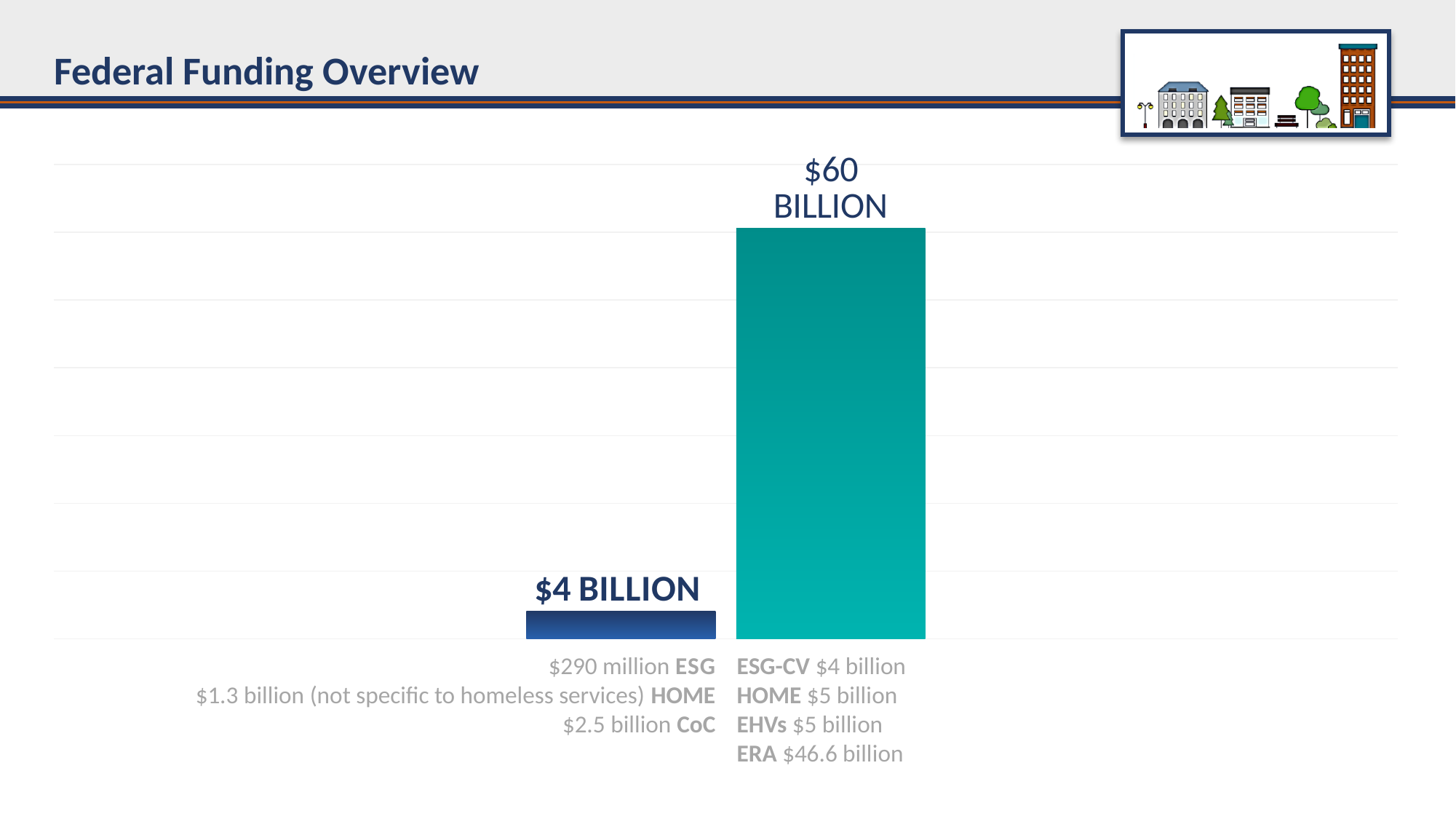
What is the difference between the value of the right bar and the value of the left bar? $56 billion According to the text under the left bar, how much funding is listed for CoC? $2.5 billion According to the text under the right bar, how much funding is listed for ERA? $46.6 billion Is the value of the left bar larger or smaller than the value of the right bar? smaller What colour is the bar labelled $60 BILLION? teal What value is labelled on the left (blue) bar? $4 BILLION What value is labelled on the right (teal) bar? $60 BILLION What kind of chart is shown on the slide? bar chart Which bar is the tallest, the left blue bar or the right teal bar? the right teal bar How many bars are plotted in the chart? 2 What is the title of the slide? Federal Funding Overview Which bar is the shortest, the left blue bar or the right teal bar? the left blue bar